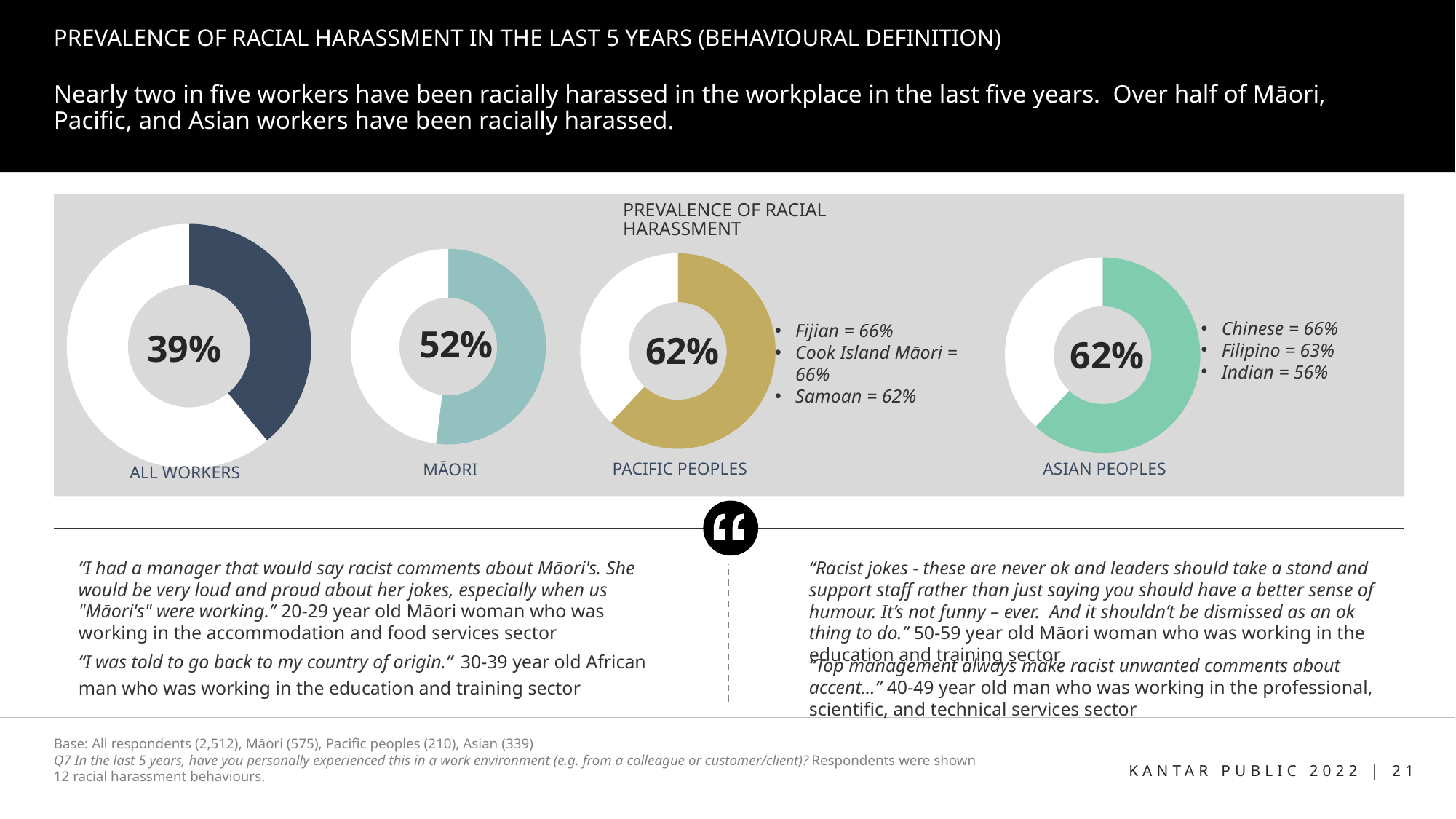
In the Asian Peoples donut chart, what percentage is shown in the centre? 62% In the All Workers donut chart, what percentage of workers have experienced racial harassment? 39% What is the difference between the percentage in the Pacific Peoples donut chart and the percentage in the All Workers donut chart? 23 percentage points Comparing the Māori and All Workers donut charts, which shows the larger percentage? Māori What type of chart is used to show the prevalence of racial harassment for each group? Donut (pie) chart How many donut charts are shown on the slide? 4 What is the difference between the percentage in the Māori donut chart and the percentage in the All Workers donut chart? 13 percentage points Next to the Pacific Peoples donut chart, what percentage is listed for Samoan? 62% Next to the Asian Peoples donut chart, what percentage is listed for Indian? 56% In the Māori donut chart, what is the prevalence of racial harassment shown? 52% Across the four donut charts, which group has the lowest prevalence of racial harassment? All Workers In the Pacific Peoples donut chart, what percentage is shown in the centre? 62%